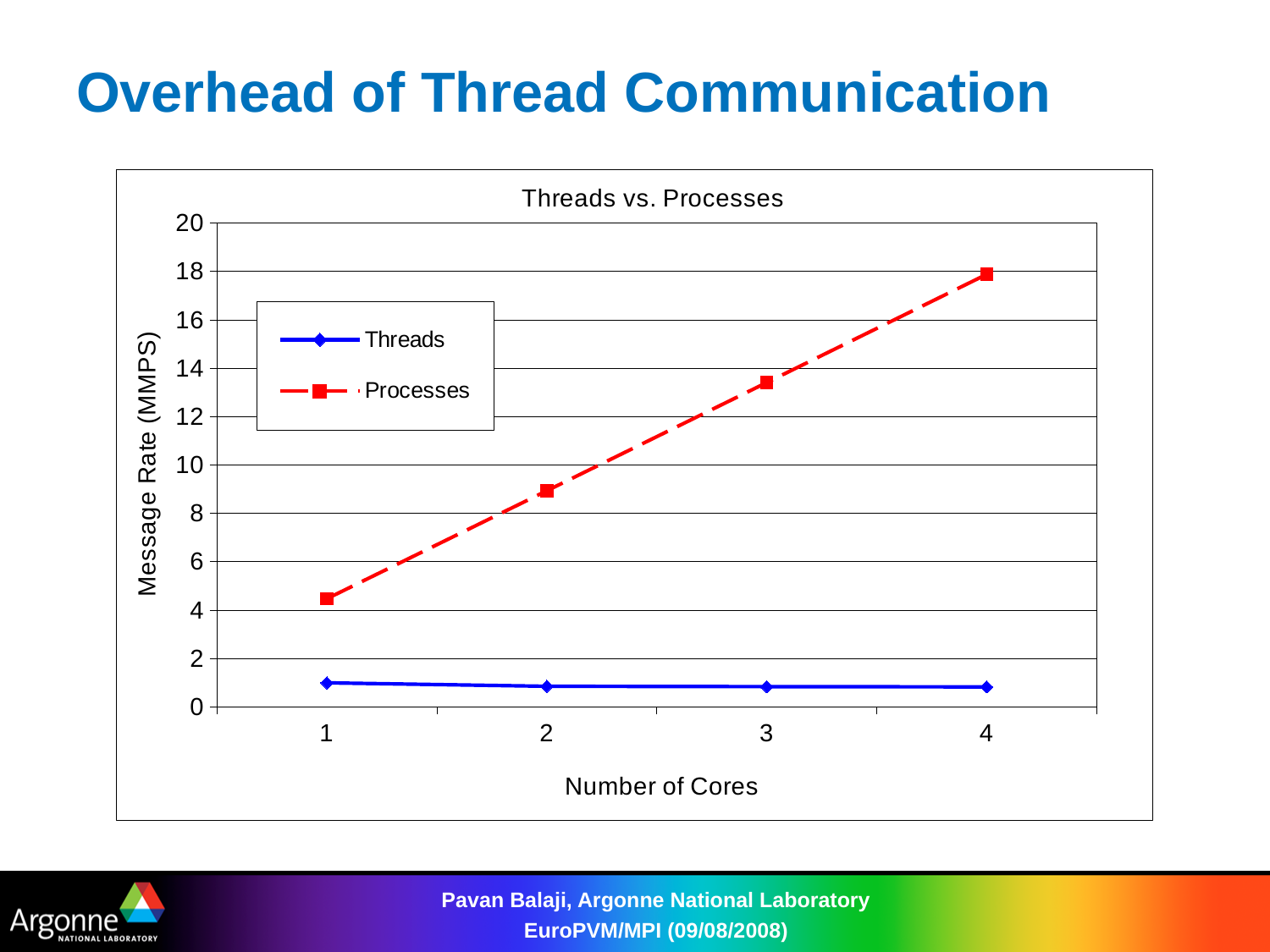
Is the Threads value at 4 cores greater or less than 2? less At which number of cores is the Processes message rate highest? 4 What kind of chart is shown on the slide? Line chart What is the label of the y axis? Message Rate (MMPS) Is the Processes value at 1 core greater or less than 6? less How many series does the legend list? 2 Is the Processes value at 4 cores greater or less than 16? greater How many Number of Cores values are plotted along the x axis? 4 Does the Processes series rise or fall as the number of cores increases? Rise At which number of cores is the Processes message rate lowest? 1 What is the title of the chart? Threads vs. Processes At 4 cores, which series has the higher message rate, Threads or Processes? Processes